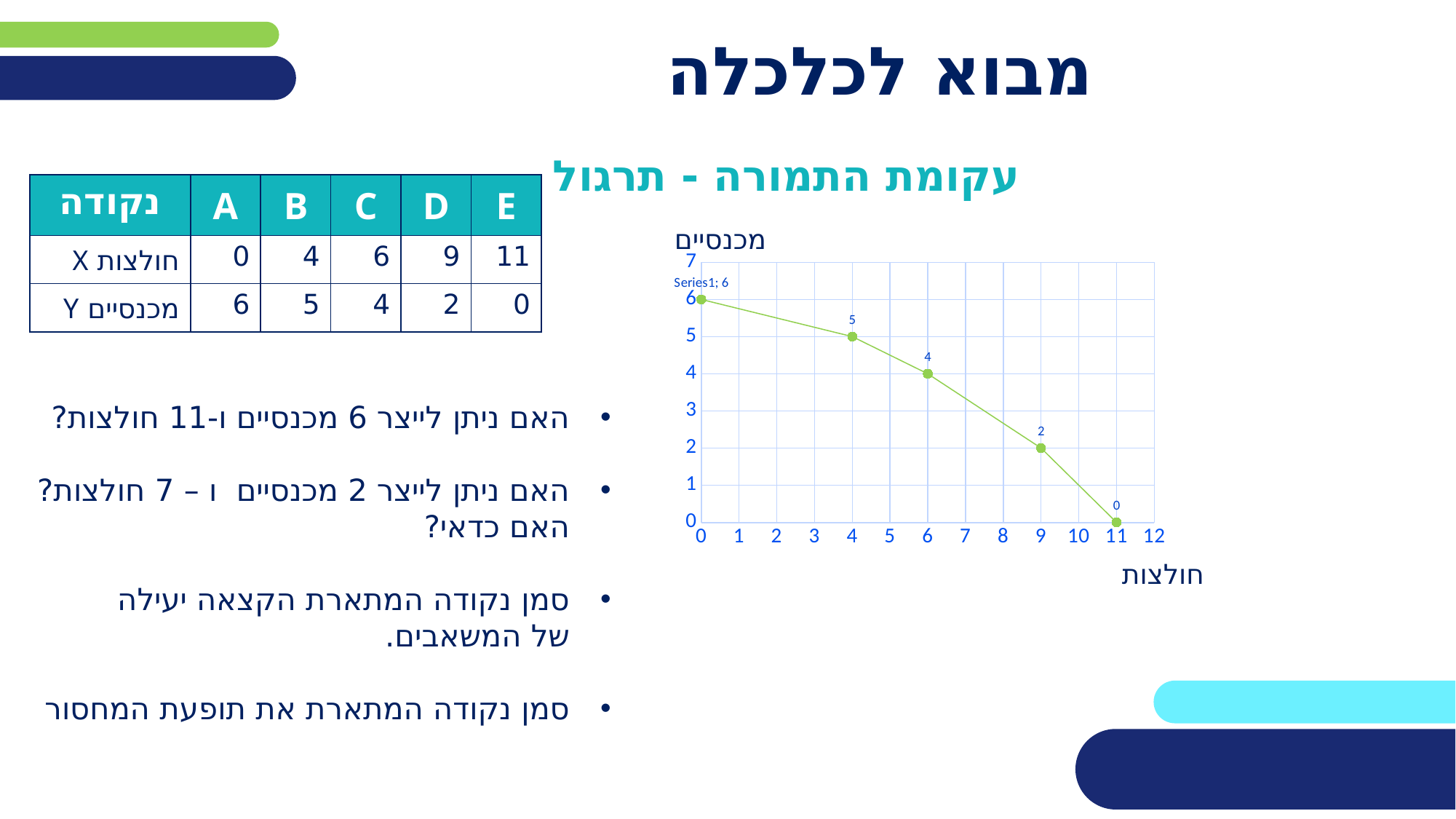
How many data points are plotted on the chart? 5 What is the value of מכנסיים when חולצות is 0? 6 What is the label of the x axis of the chart? חולצות What kind of chart is shown on the slide? line chart What is the value of מכנסיים when חולצות is 6? 4 What is the difference in מכנסיים between חולצות = 4 and חולצות = 9? 3 At which value of חולצות is מכנסיים highest? 0 At which value of חולצות is מכנסיים lowest? 11 What is the value of מכנסיים when חולצות is 9? 2 Do the values of מכנסיים rise or fall as חולצות increases along the x axis? fall What is the value of מכנסיים when חולצות is 11? 0 What is the value of מכנסיים (pants) when חולצות (shirts) is 4? 5